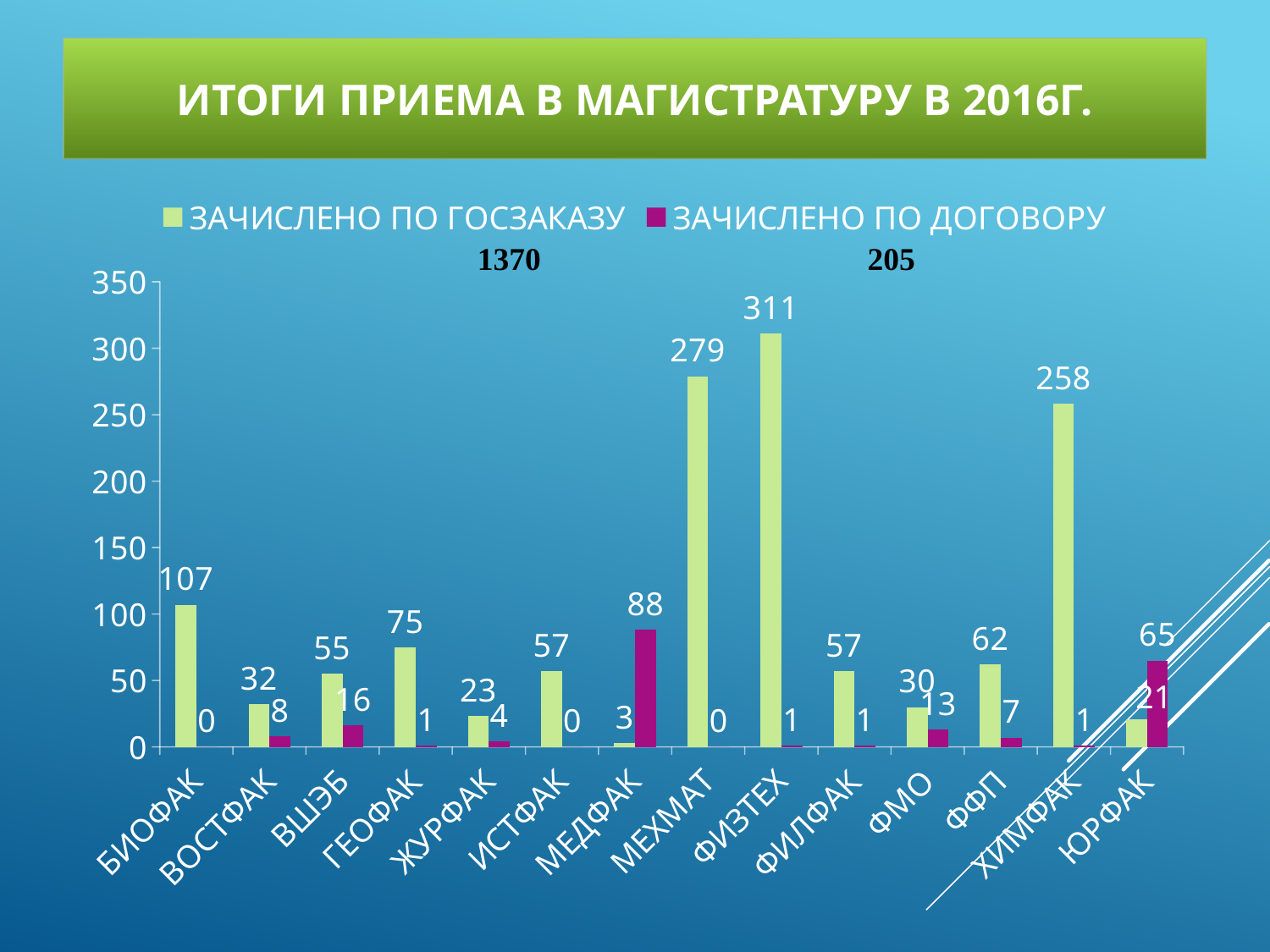
What is the title of the slide? ИТОГИ ПРИЕМА В МАГИСТРАТУРУ В 2016Г. What is the difference between the ЗАЧИСЛЕНО ПО ГОСЗАКАЗУ values for ФИЗТЕХ and МЕХМАТ? 32 What is the value of ЗАЧИСЛЕНО ПО ДОГОВОРУ for ВШЭБ? 16 What kind of chart is shown on the slide? Bar chart For ЮРФАК, how much larger is ЗАЧИСЛЕНО ПО ДОГОВОРУ than ЗАЧИСЛЕНО ПО ГОСЗАКАЗУ? 44 Which category has the highest value for ЗАЧИСЛЕНО ПО ДОГОВОРУ? МЕДФАК How many categories are shown on the x axis? 14 How many series does the legend list? 2 What is the value of ЗАЧИСЛЕНО ПО ГОСЗАКАЗУ for ФИЗТЕХ? 311 Which has a larger ЗАЧИСЛЕНО ПО ГОСЗАКАЗУ value, ХИМФАК or МЕХМАТ? МЕХМАТ Which category has the highest value for ЗАЧИСЛЕНО ПО ГОСЗАКАЗУ? ФИЗТЕХ What is the value of ЗАЧИСЛЕНО ПО ДОГОВОРУ for МЕДФАК? 88